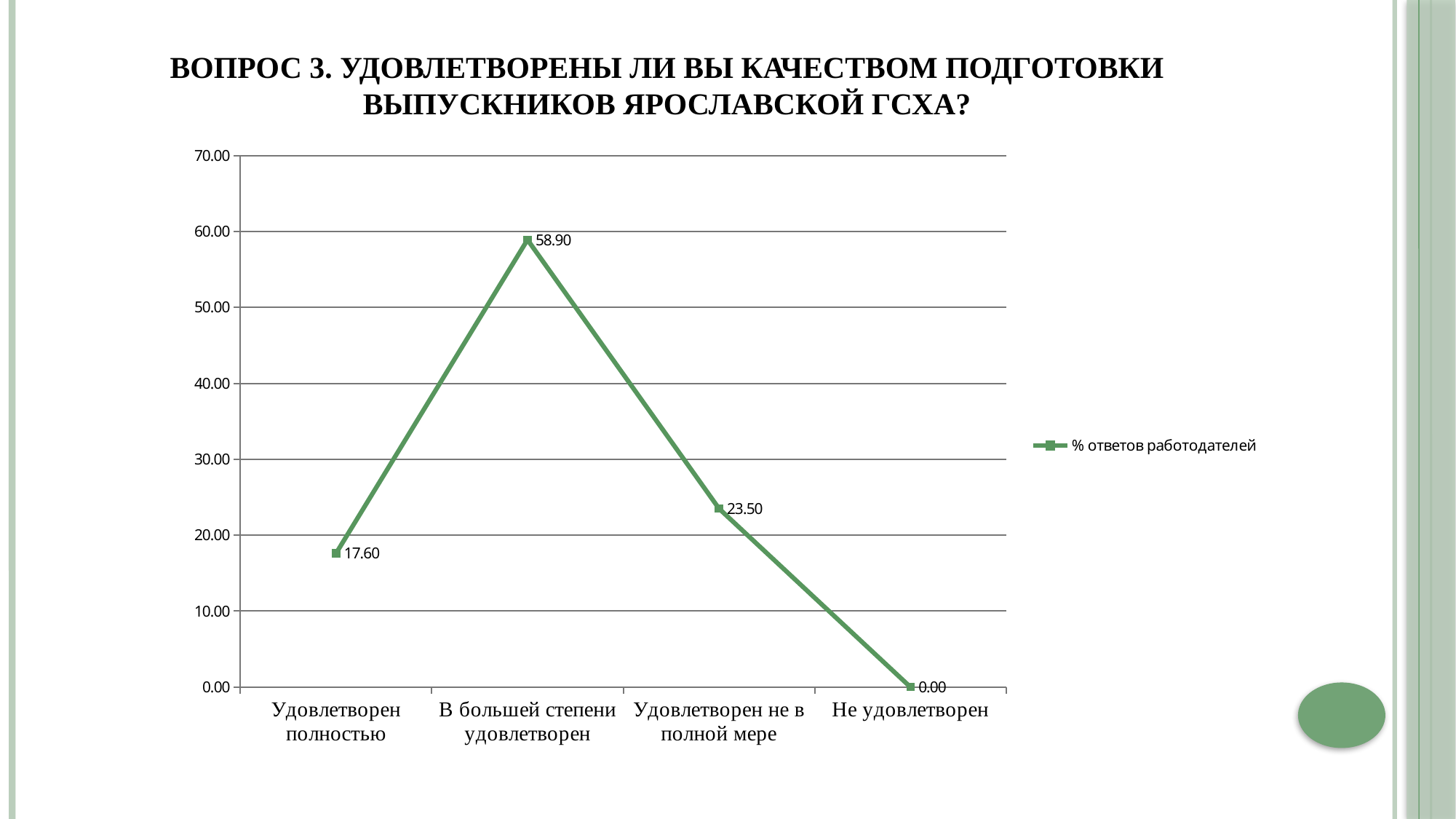
What is the value for "Не удовлетворен"? 0.00 How many categories are shown on the x axis? 4 What is the value for "В большей степени удовлетворен"? 58.90 What series name does the legend show? % ответов работодателей What is the difference between the values for "В большей степени удовлетворен" and "Удовлетворен не в полной мере"? 35.40 What is the value for "Удовлетворен полностью"? 17.60 What kind of chart is shown on the slide? line chart Which is larger: the value for "Удовлетворен полностью" or the value for "Удовлетворен не в полной мере"? Удовлетворен не в полной мере Is the value for "В большей степени удовлетворен" greater or less than 50.00? greater What is the value for "Удовлетворен не в полной мере"? 23.50 Which category has the lowest value? Не удовлетворен Which category has the highest value? В большей степени удовлетворен